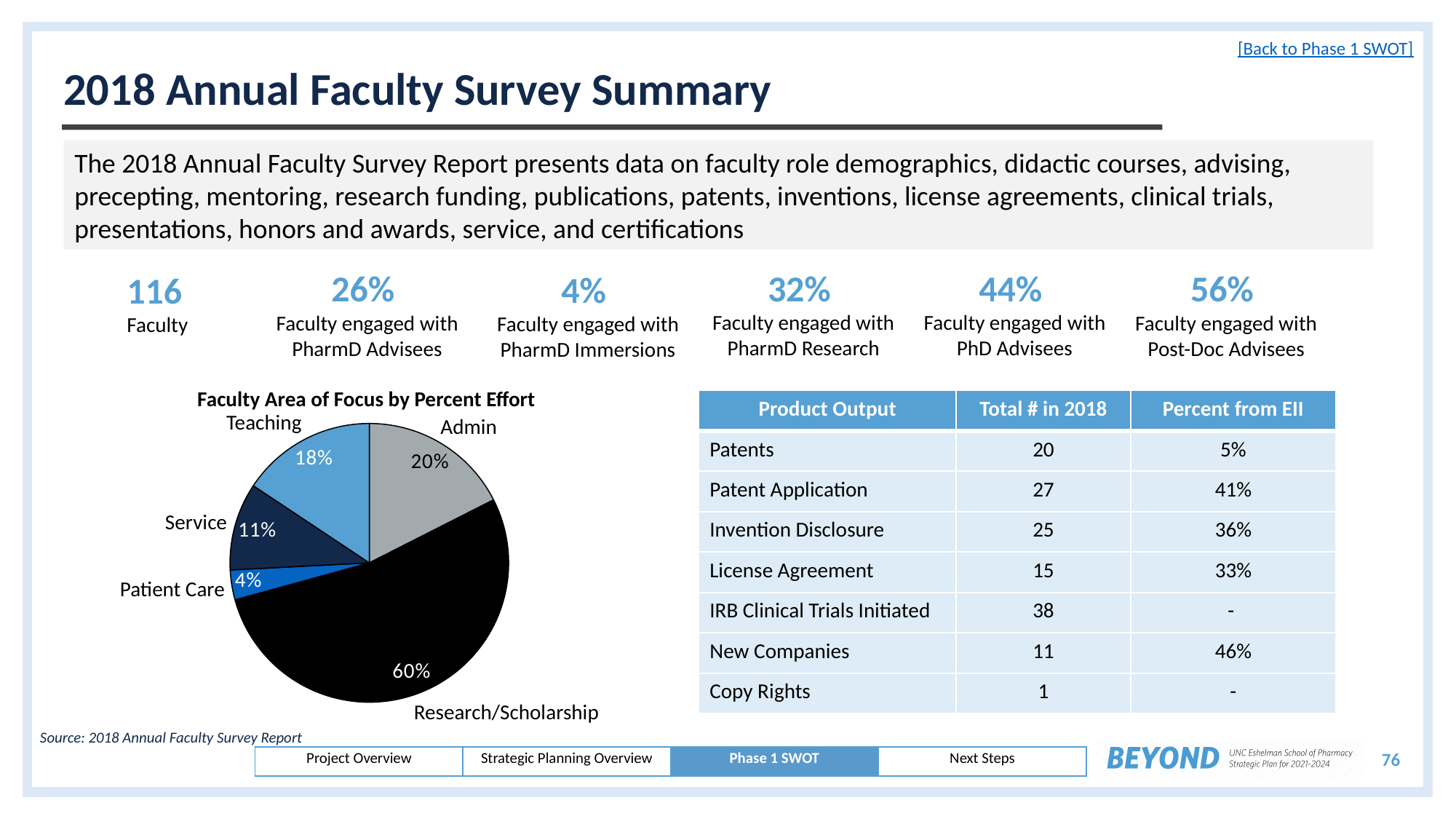
What percent effort is shown for Admin in the pie chart? 20% What is the difference between the Admin and Teaching percentages in the pie chart? 2% What type of chart is shown on the slide? Pie chart What percent effort is shown for Teaching in the pie chart? 18% What is the title of the pie chart? Faculty Area of Focus by Percent Effort What percent effort is shown for Research/Scholarship in the pie chart? 60% What percent effort is shown for Service in the pie chart? 11% How many slices does the pie chart have? 5 Which area of focus has the smallest slice in the pie chart? Patient Care What percent effort is shown for Patient Care in the pie chart? 4% Which is larger in the pie chart, Service or Teaching? Teaching Which area of focus has the largest slice in the pie chart? Research/Scholarship